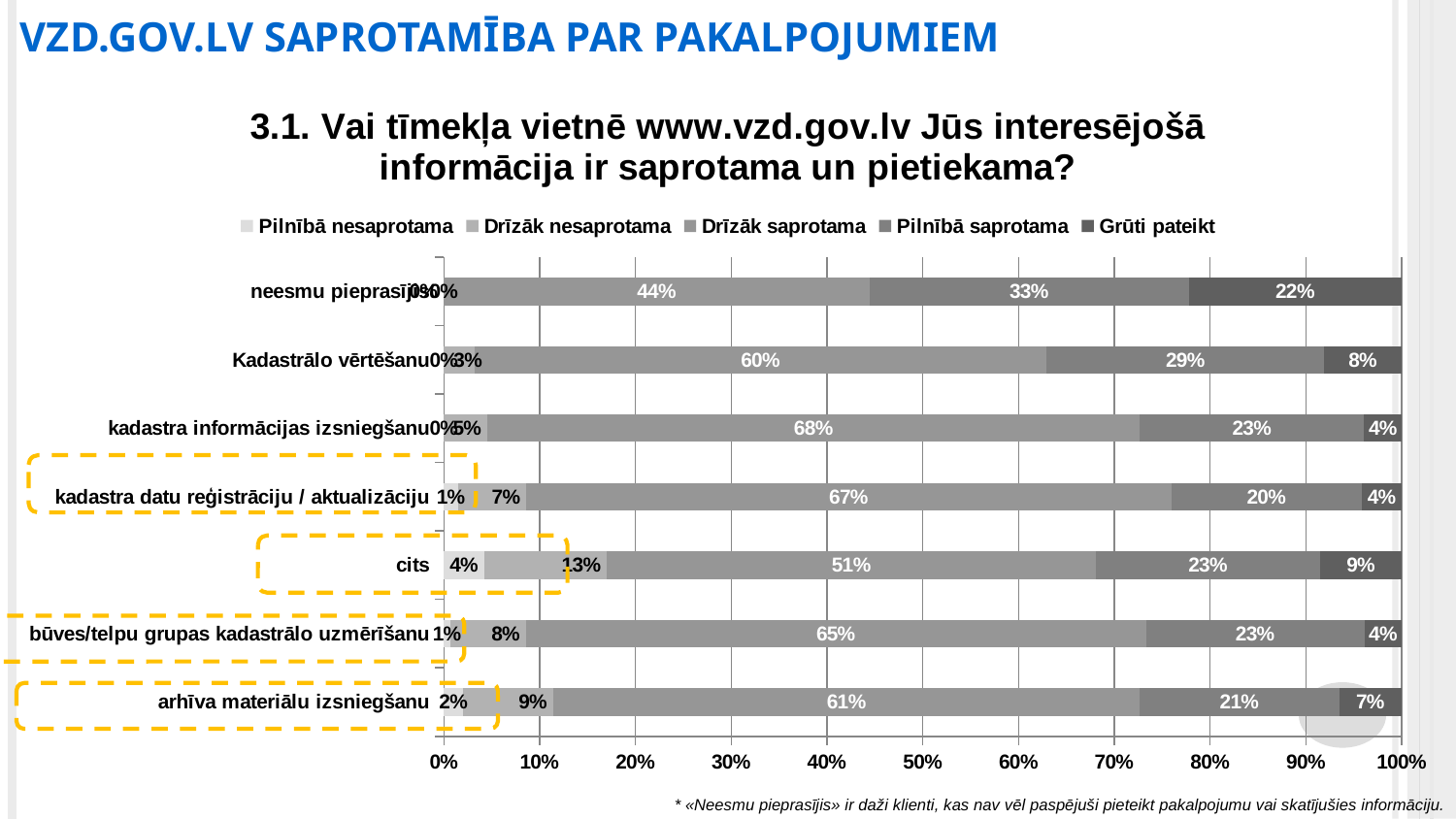
What kind of chart is shown on the slide? Stacked bar chart What is the 'Drīzāk nesaprotama' value for 'cits'? 13% What is the difference between the 'Pilnībā saprotama' values for 'Kadastrālo vērtēšanu' and 'cits'? 6 percentage points How many categories (bars) are shown in the chart? 7 Is the 'Drīzāk saprotama' value for 'Kadastrālo vērtēšanu' greater or less than 50%? greater Which category has the lowest 'Drīzāk saprotama' value? neesmu pieprasījis What is the 'Grūti pateikt' value for 'neesmu pieprasījis'? 22% How many series does the legend list? 5 What is the 'Drīzāk saprotama' value for 'kadastra informācijas izsniegšanu'? 68% Which has the larger 'Grūti pateikt' value: 'cits' or 'arhīva materiālu izsniegšanu'? cits What is the first entry in the chart legend? Pilnībā nesaprotama Which category has the highest 'Pilnībā saprotama' value? neesmu pieprasījis